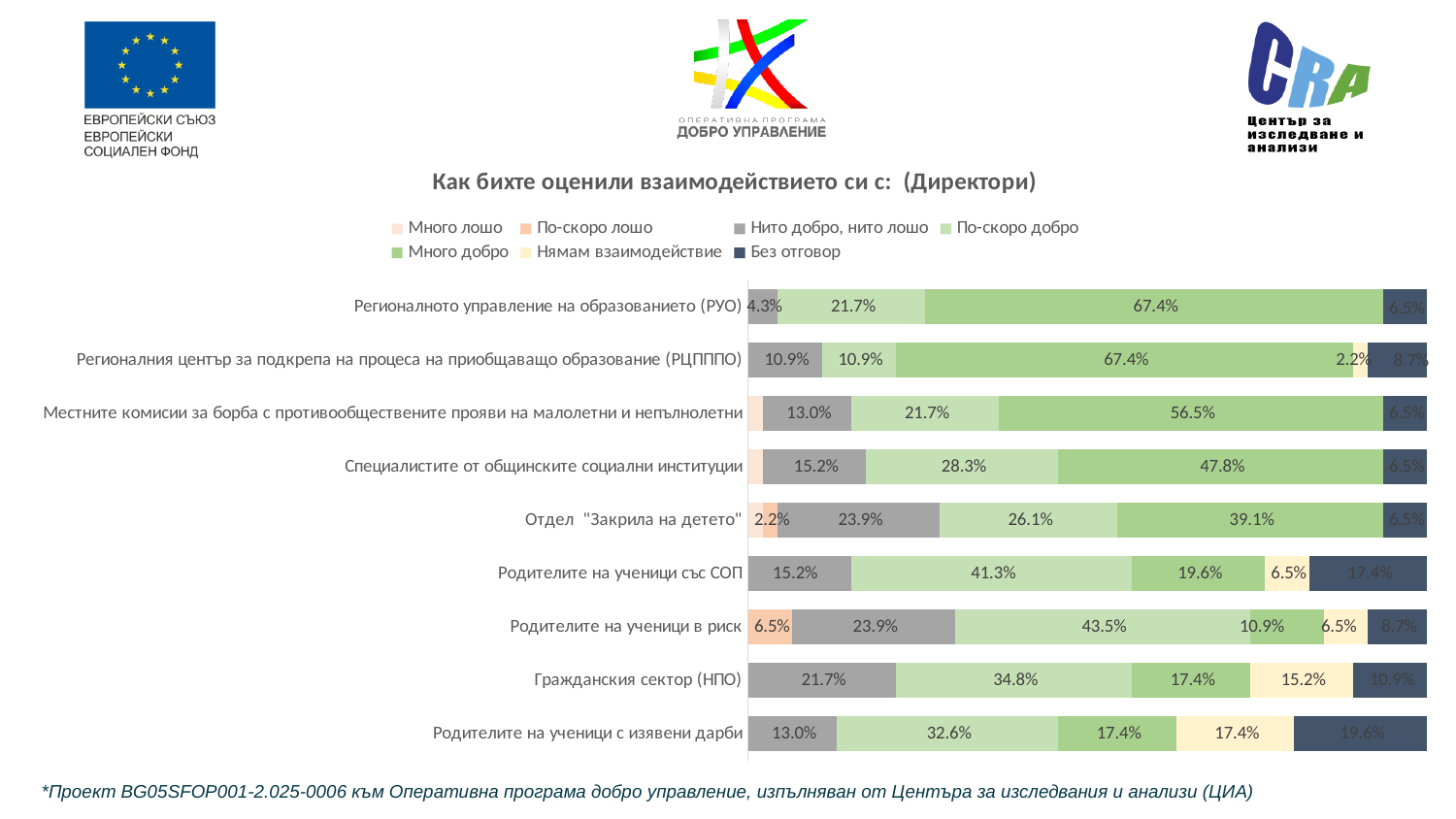
Which category has the highest 'По-скоро добро' value? Родителите на ученици в риск What is the difference between the 'Много добро' values for 'Регионалното управление на образованието (РУО)' and 'Местните комисии за борба с противообществените прояви на малолетни и непълнолетни'? 10.9 percentage points How many series does the legend list? 7 What is the title of the chart? Как бихте оценили взаимодействието си с: (Директори) What is the 'Нямам взаимодействие' value for 'Гражданския сектор (НПО)'? 15.2% Which category has the highest 'Без отговор' value? Родителите на ученици с изявени дарби What is the 'Без отговор' value for 'Родителите на ученици с изявени дарби'? 19.6% What kind of chart is shown on the slide? Stacked bar chart What is the 'Много добро' value for 'Регионалното управление на образованието (РУО)'? 67.4% What is the 'По-скоро добро' value for 'Родителите на ученици със СОП'? 41.3% Which is larger: the 'Нито добро, нито лошо' value for 'Отдел "Закрила на детето"' or for 'Специалистите от общинските социални институции'? Отдел "Закрила на детето" How many categories (rows) are plotted in the chart? 9